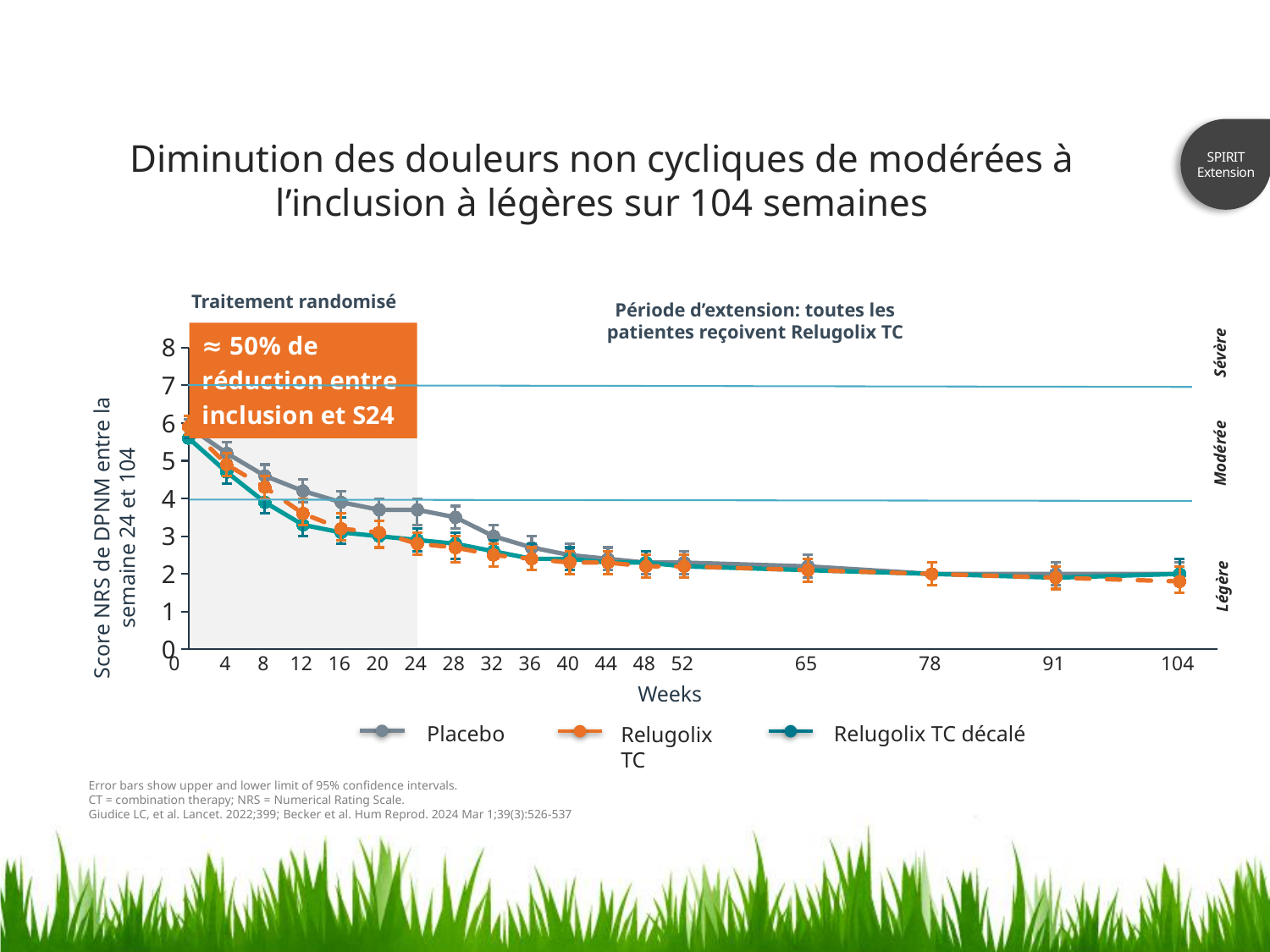
What kind of chart is shown on the slide? line chart How many series does the legend list? 3 Is the value for Relugolix TC décalé at week 78 greater or less than 3? less At week 8, which series has the higher value, Placebo or Relugolix TC décalé? Placebo Is the value for Relugolix TC at week 0 greater or less than 5? greater At week 16, which series has the higher value, Placebo or Relugolix TC décalé? Placebo Do the NRS scores rise or fall as the weeks increase along the x axis? fall Is the value for Placebo at week 0 greater or less than 5? greater What is the label of the x axis? Weeks Which series are listed in the legend? Placebo, Relugolix TC, Relugolix TC décalé